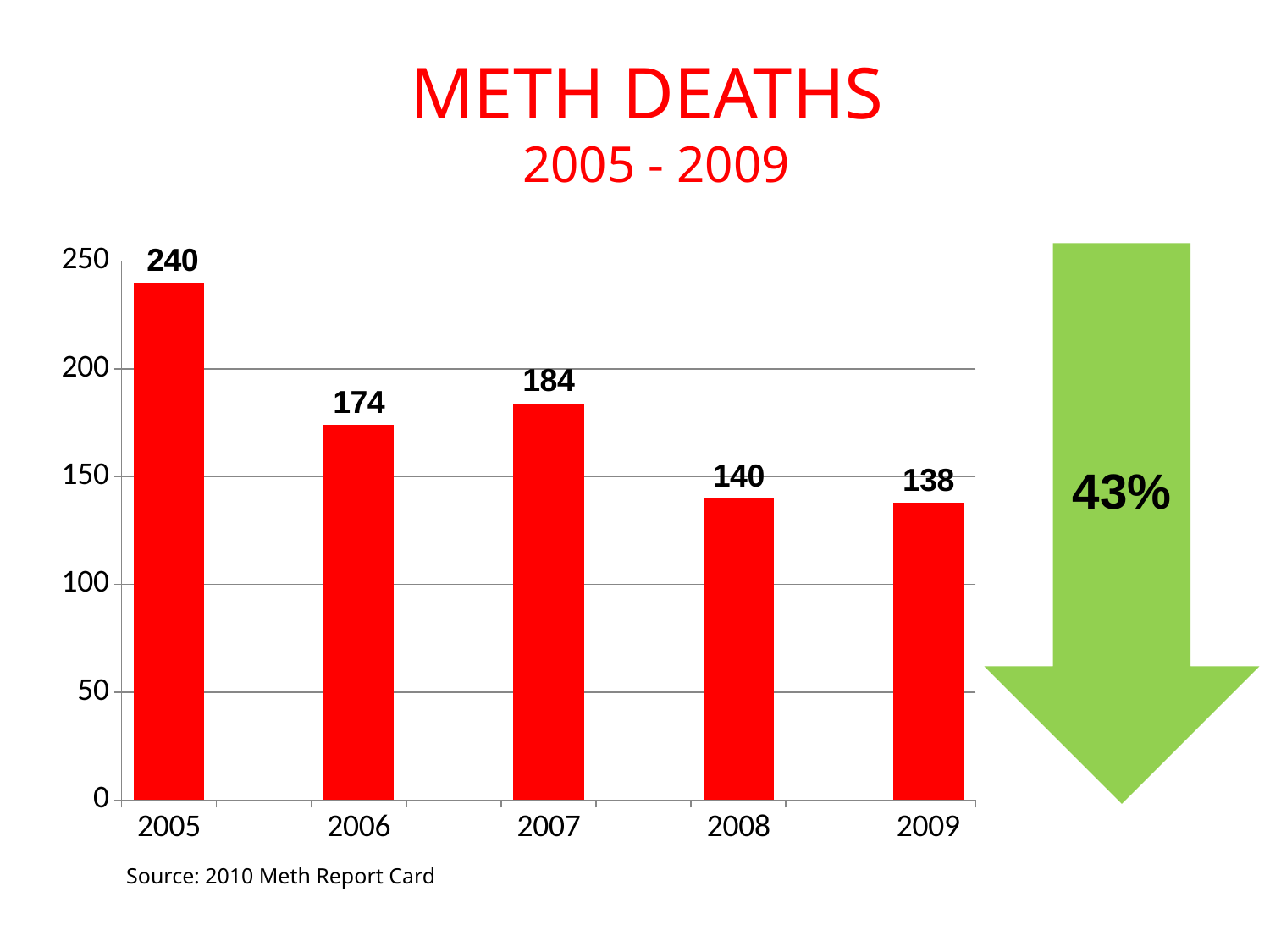
How many years are shown on the chart? 5 Which year has the lowest number of meth deaths? 2009 What is the number of meth deaths in 2005? 240 What is the difference in meth deaths between 2006 and 2007? 10 What percentage decrease is shown in the green arrow next to the chart? 43% What kind of chart is shown on the slide? bar chart What is the number of meth deaths in 2007? 184 Which year has the highest number of meth deaths? 2005 Is the value for 2008 greater or less than 150? less Which year had more meth deaths, 2006 or 2007? 2007 What is the number of meth deaths in 2009? 138 What is the difference in meth deaths between 2005 and 2009? 102